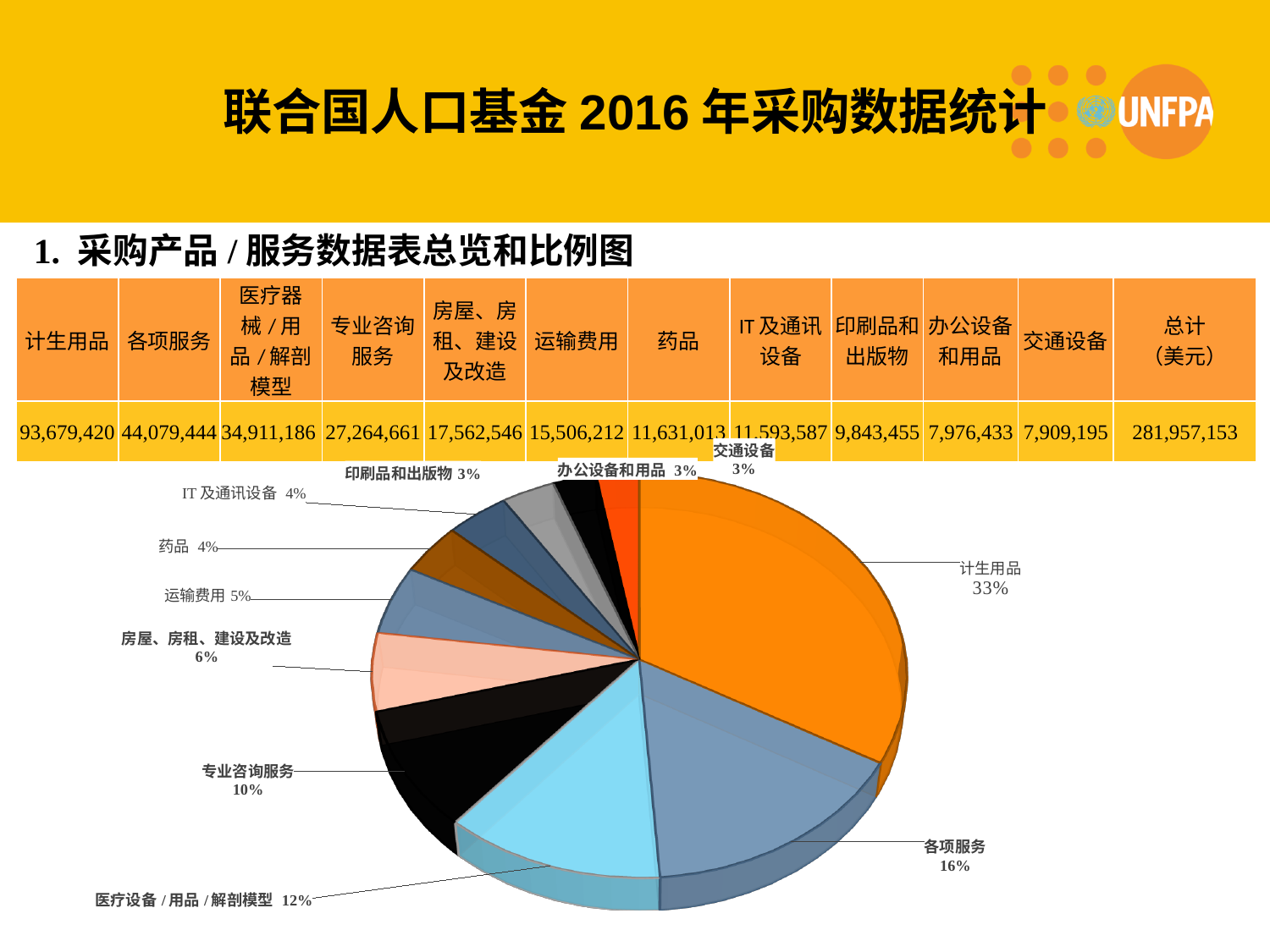
What is the difference in percentage points between 计生用品 and 各项服务 in the pie chart? 17 What percentage is shown for 各项服务 in the pie chart? 16% What share of the pie does 专业咨询服务 represent? 10% What percentage is shown for 医疗设备/用品/解剖模型 in the pie chart? 12% What kind of chart is shown on the slide? pie chart What percentage is shown for 药品 in the pie chart? 4% What percentage is labelled for 房屋、房租、建设及改造 in the pie chart? 6% What percentage is shown for 运输费用 in the pie chart? 5% How many slices does the pie chart have? 11 Which category has the largest slice in the pie chart? 计生用品 What share of the pie does 计生用品 account for? 33% Which is larger in the pie chart, 各项服务 or 专业咨询服务? 各项服务